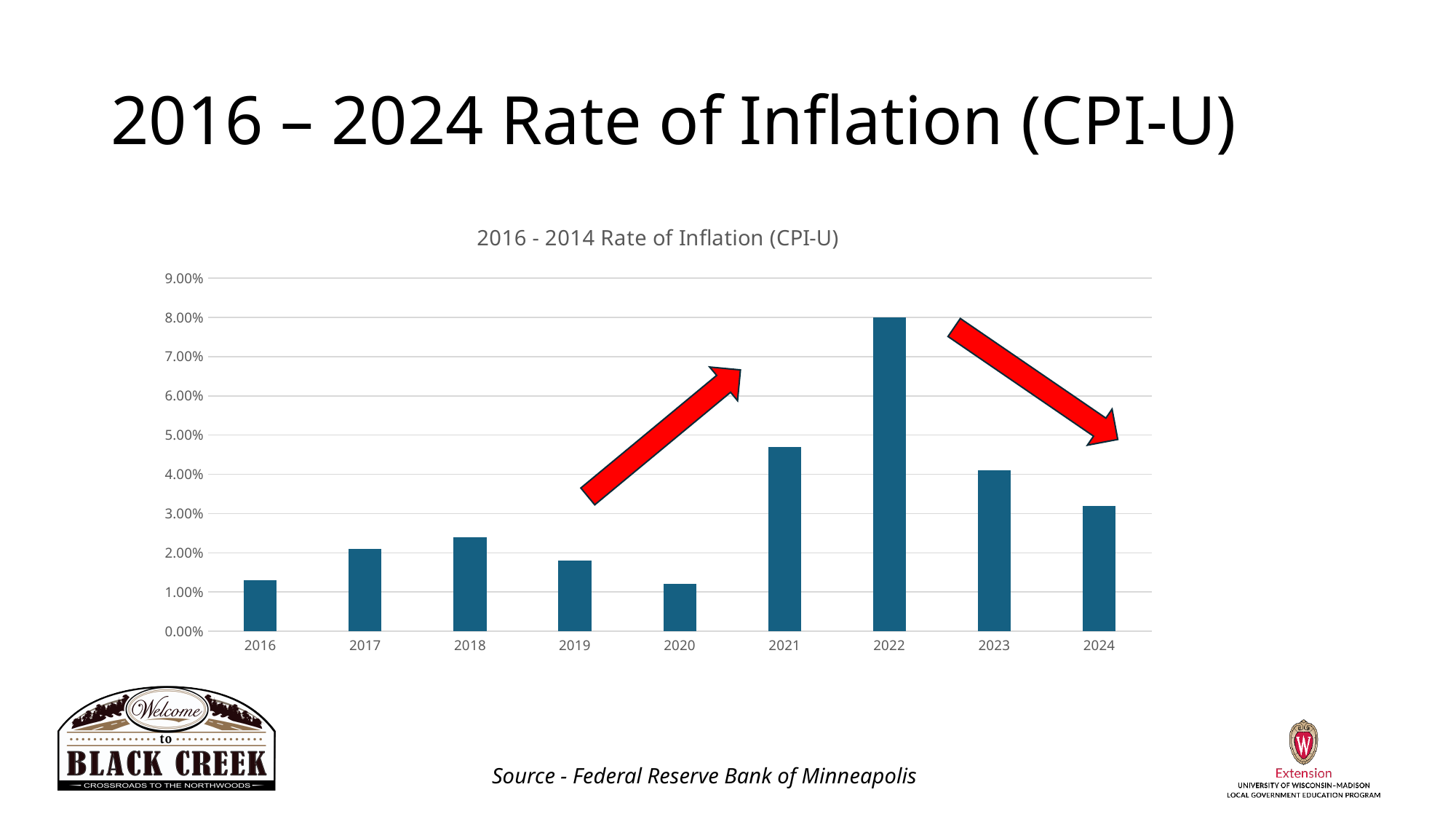
Which year has the highest rate of inflation? 2022 What kind of chart is shown on the slide? Bar chart What is the rate of inflation shown for 2022? 8.00% What is the title printed above the chart? 2016 - 2014 Rate of Inflation (CPI-U) Is the value for 2021 greater or less than 4.00%? greater Do the values rise or fall from 2022 to 2024? Fall Which year has the larger rate of inflation, 2021 or 2023? 2021 Is the value for 2020 greater or less than 2.00%? less Is the value for 2016 greater or less than 2.00%? less How many years are shown on the x axis? 9 Which year has the larger rate of inflation, 2018 or 2019? 2018